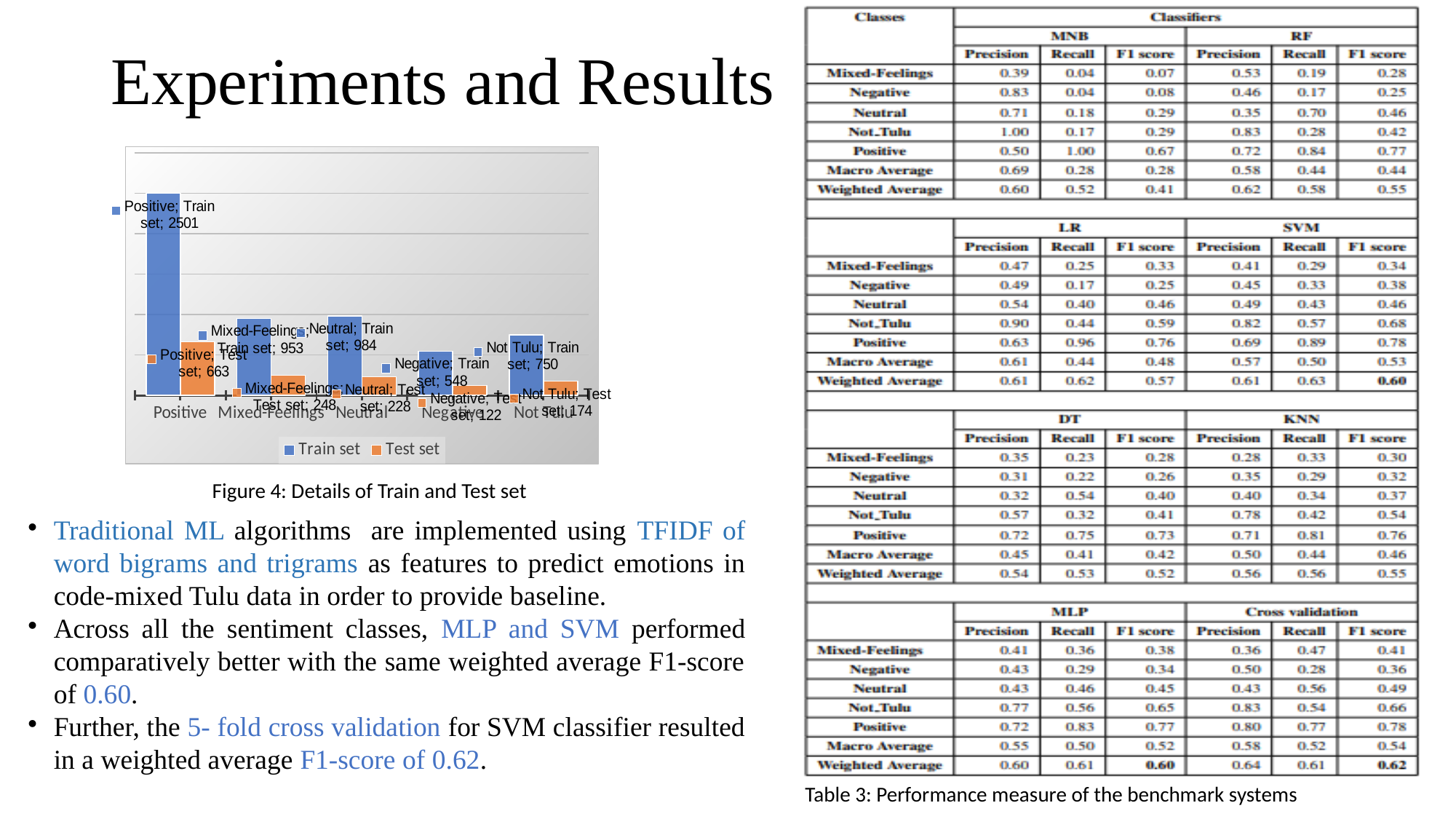
What is the Train set value for Not Tulu? 750 What kind of chart is shown in Figure 4? Bar chart Which category has the lowest Test set value? Negative What is the Test set value for Negative? 122 Which is larger, the Train set value for Neutral or the Train set value for Mixed-Feelings? Neutral How many categories are shown on the x axis of the chart? 5 What is the caption of the chart? Figure 4: Details of Train and Test set What is the Train set value for Positive? 2501 Which category has the highest Train set value? Positive How many series does the chart legend list? 2 What is the Test set value for Neutral? 228 What is the difference between the Train set and Test set values for Positive? 1838